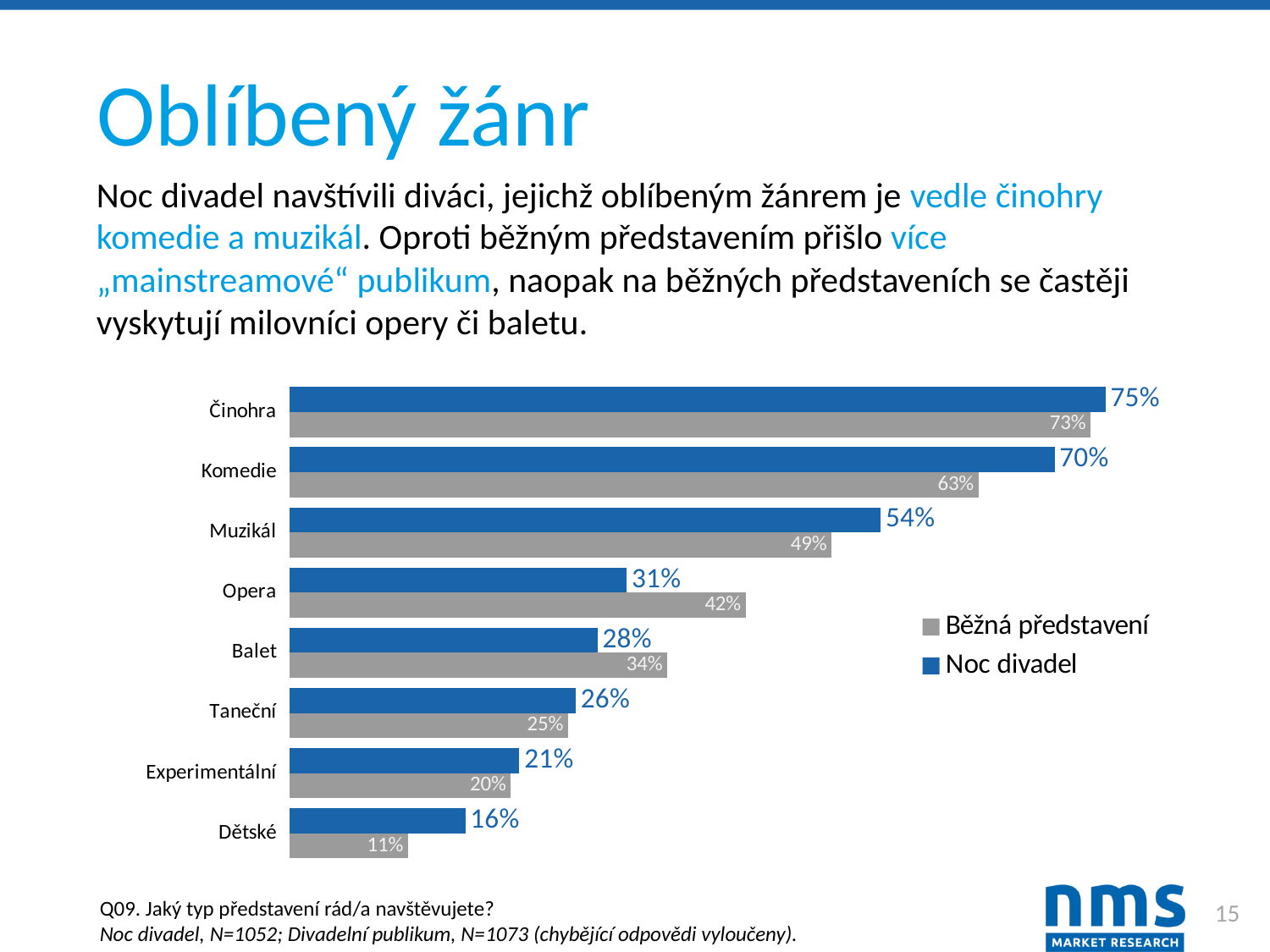
Which colour represents the Noc divadel series in the chart? Blue What is the value for Opera in the Běžná představení series? 42% Which category has the highest value in the Noc divadel series? Činohra What is the difference between the Běžná představení and Noc divadel values for Opera? 11% What is the value for Činohra in the Noc divadel series? 75% For Balet, which series has the larger value: Noc divadel or Běžná představení? Běžná představení What kind of chart is shown on the slide? Bar chart How many categories are shown on the chart? 8 How many series does the legend list? 2 What is the value for Dětské in the Noc divadel series? 16% What is the difference between the Noc divadel and Běžná představení values for Komedie? 7% Which category has the lowest value in the Běžná představení series? Dětské